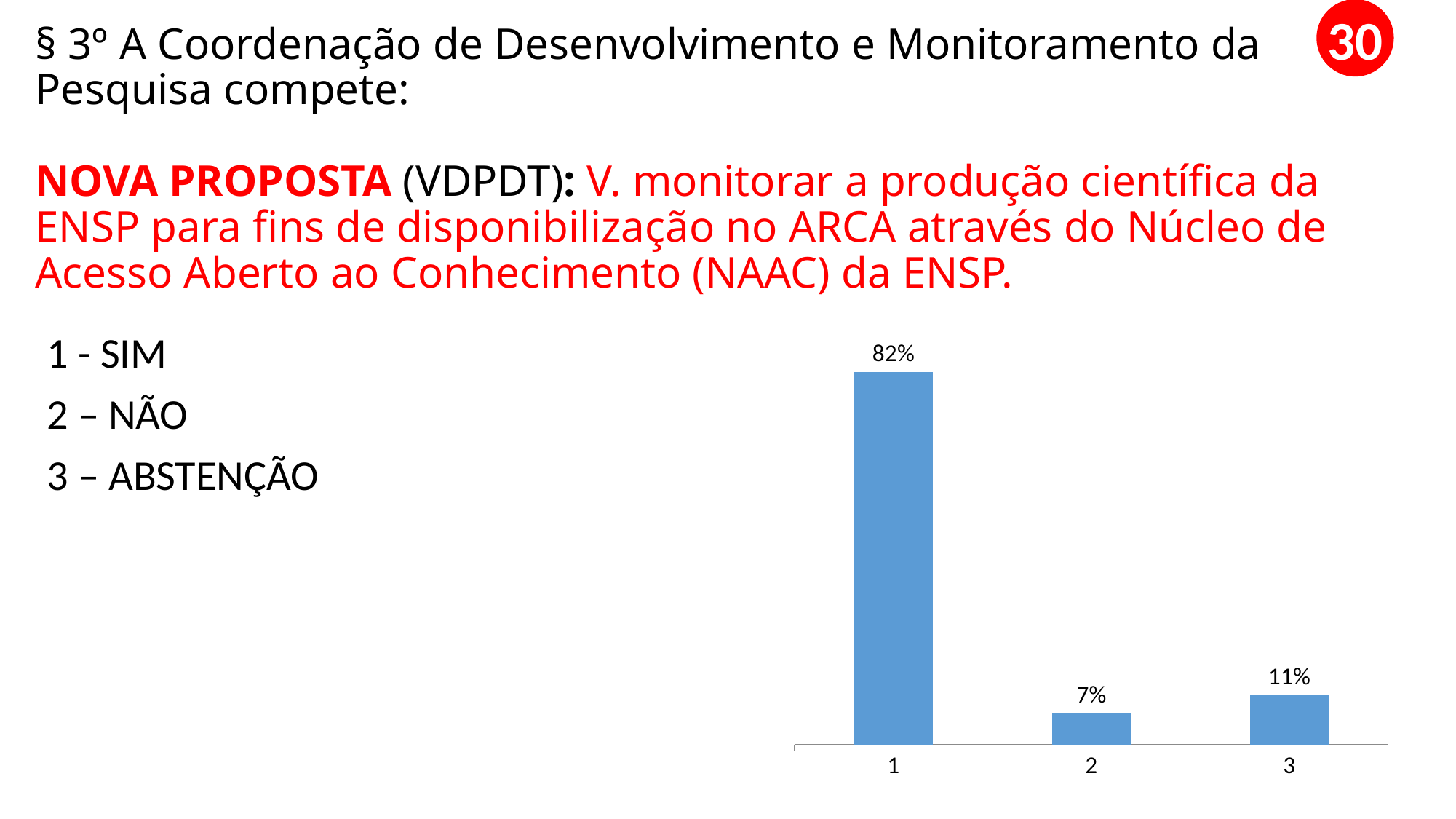
What is the total of the three values shown in the chart? 100% What kind of chart is shown on the slide? bar chart What is the value shown for category 3? 11% Which is larger, the value for category 2 or category 3? 3 What colour are the bars in the chart? blue What is the value shown for category 2? 7% Which category has the lowest value? 2 What is the difference between the values for category 1 and category 3? 71% What is the difference between the values for category 3 and category 2? 4% How many bars are plotted in the chart? 3 What is the value shown for category 1? 82% Which category has the highest value? 1